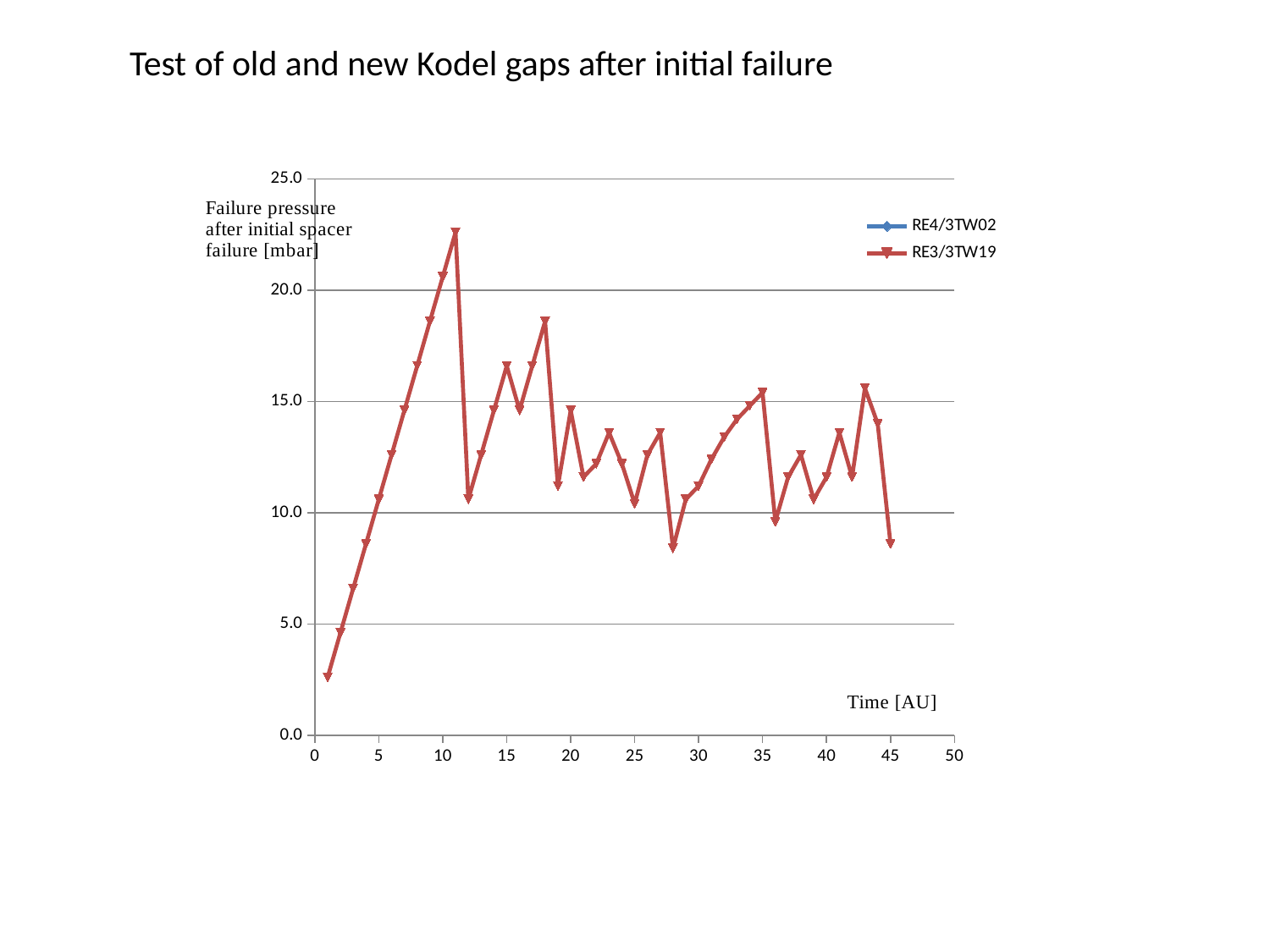
How many series does the legend list? 2 What kind of chart is shown on the slide? line chart Is the value for RE3/3TW19 at time 11 greater or less than 20.0? greater Is the value for RE3/3TW19 at time 28 greater or less than 10.0? less At which time value does the RE3/3TW19 series have its lowest failure pressure? 1 What is the title of the slide's chart? Test of old and new Kodel gaps after initial failure Is the value for RE3/3TW19 at time 18 greater or less than 15.0? greater At which time value does the RE3/3TW19 series reach its highest failure pressure? 11 Which has the larger failure pressure for RE3/3TW19: time 11 or time 18? time 11 Between time 1 and time 11, does the RE3/3TW19 series rise or fall? rise What is the label of the x axis? Time [AU]